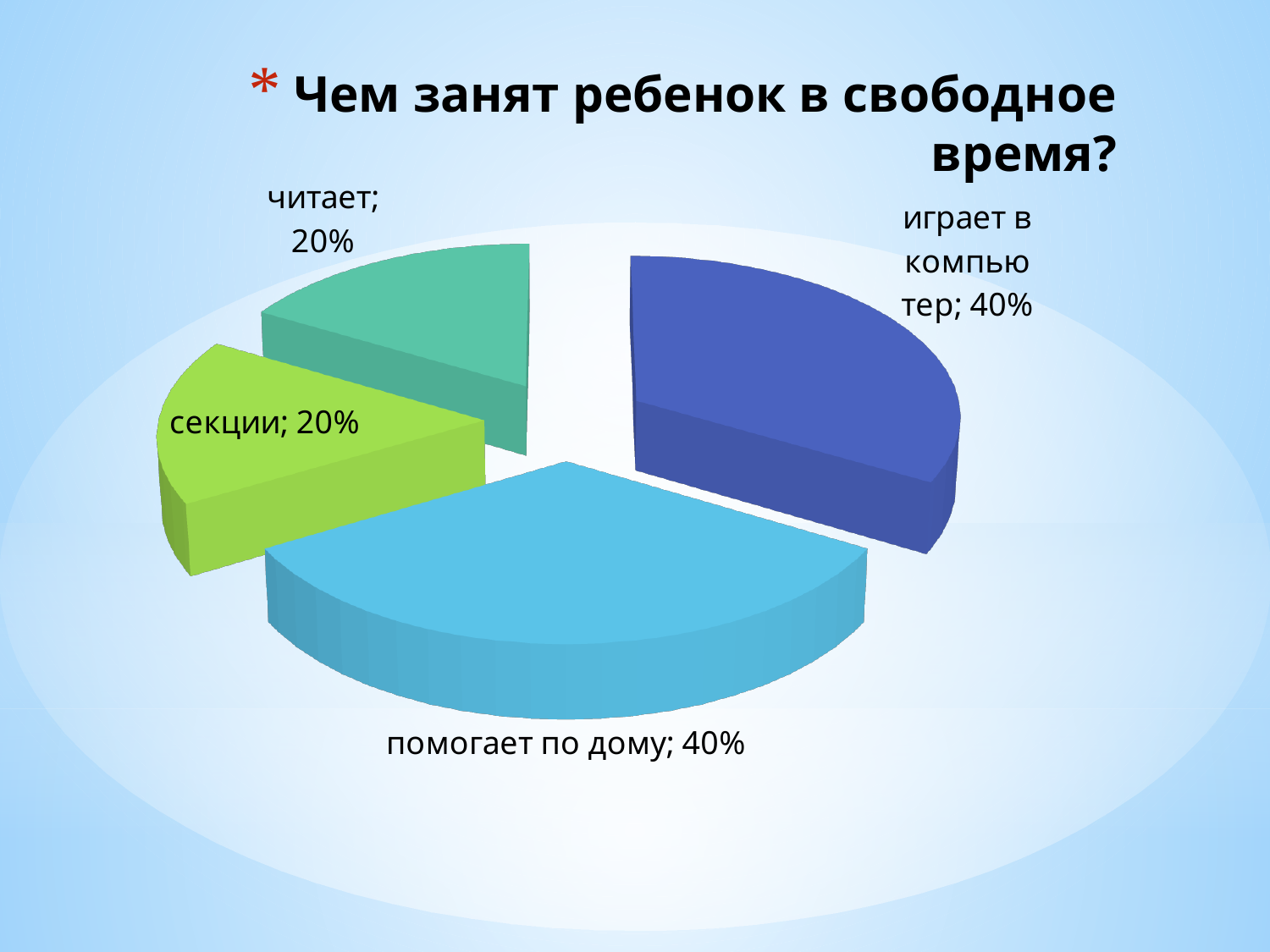
Which is larger, the share for "играет в компьютер" or the share for "читает"? играет в компьютер Which is larger, the share for "секции" or the share for "помогает по дому"? помогает по дому What is the title of the chart? Чем занят ребенок в свободное время? What is the difference in percentage points between "помогает по дому" and "секции"? 20 What is the difference in percentage points between "играет в компьютер" and "читает"? 20 How many slices does the pie chart have? 4 What percentage is shown for "играет в компьютер"? 40% What colour is the slice for "секции"? green What percentage is shown for "читает"? 20% What kind of chart is shown on the slide? pie chart What percentage is shown for "помогает по дому"? 40% What percentage is shown for "секции"? 20%